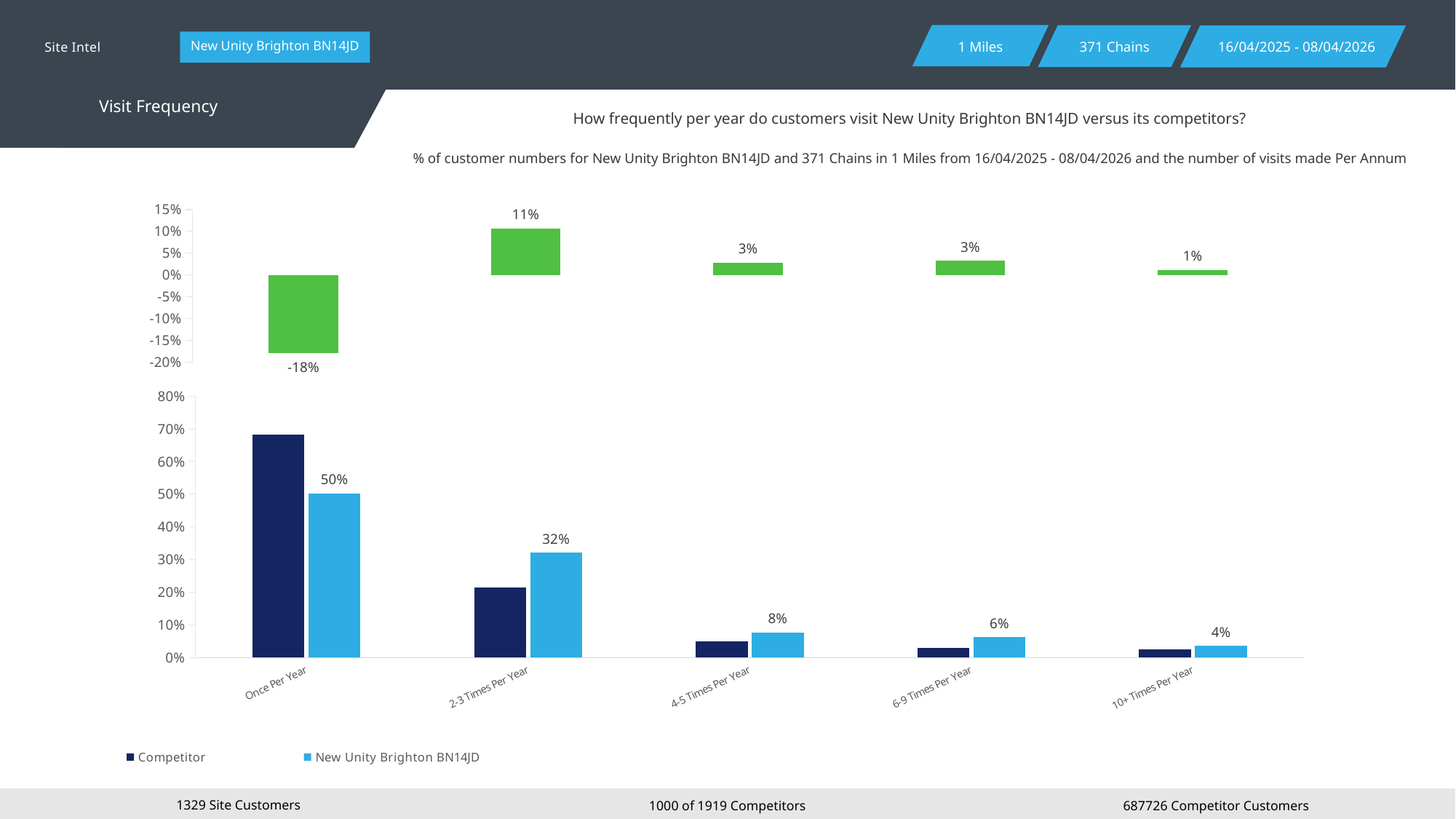
In the bottom chart, for Once Per Year, which is larger: Competitor or New Unity Brighton BN14JD? Competitor Do the New Unity Brighton BN14JD values in the bottom chart rise or fall from left to right? fall How many categories are shown on the x axis of the bottom chart? 5 In the bottom chart, what is the value for New Unity Brighton BN14JD for Once Per Year? 50% In the top chart, what is the value for Once Per Year? -18% In the top chart, what is the value for 2-3 Times Per Year? 11% How many series does the legend of the bottom chart list? 2 In the bottom chart, what is the value for New Unity Brighton BN14JD for 10+ Times Per Year? 4% In the bottom chart, what is the difference between the New Unity Brighton BN14JD values for Once Per Year and 2-3 Times Per Year? 18 percentage points In the top chart, which category has the highest value? 2-3 Times Per Year In the top chart, which category has the lowest value? Once Per Year In the bottom chart, is the Competitor value for Once Per Year greater or less than 60%? greater